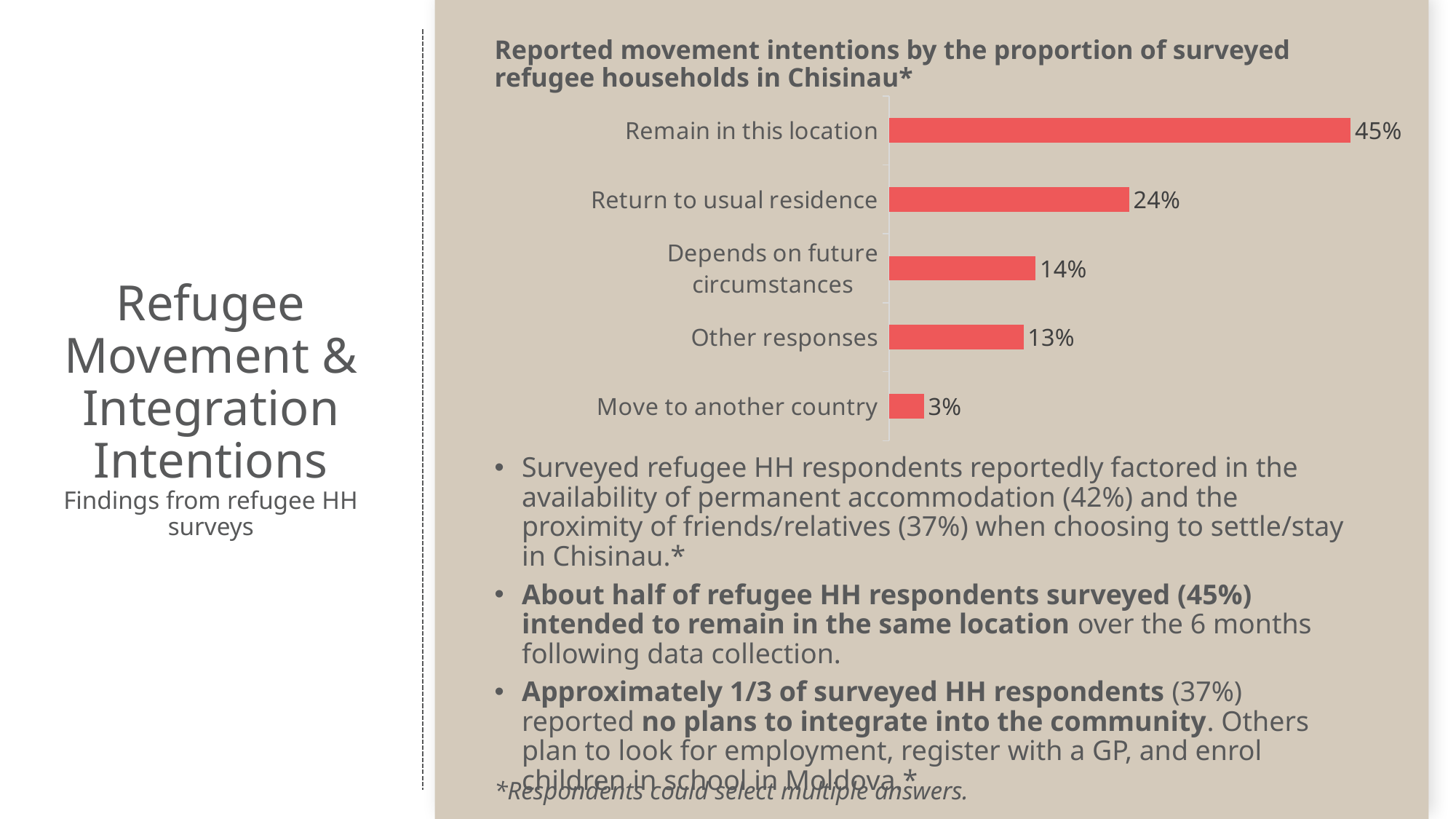
How many movement intention categories are shown in the chart? 5 What is the difference in percentage points between 'Remain in this location' and 'Return to usual residence'? 21 What is the value for 'Return to usual residence'? 24% What proportion of households said their intention depends on future circumstances? 14% What type of chart is used to show the reported movement intentions? Bar chart What percentage of surveyed refugee households reported intending to remain in this location? 45% What is the difference in percentage points between 'Other responses' and 'Move to another country'? 10 What is the title of the chart? Reported movement intentions by the proportion of surveyed refugee households in Chisinau* Which is larger: the value for 'Depends on future circumstances' or the value for 'Other responses'? Depends on future circumstances Which movement intention has the lowest proportion of surveyed households? Move to another country Which movement intention has the highest proportion of surveyed households? Remain in this location What is the value shown for 'Move to another country'? 3%